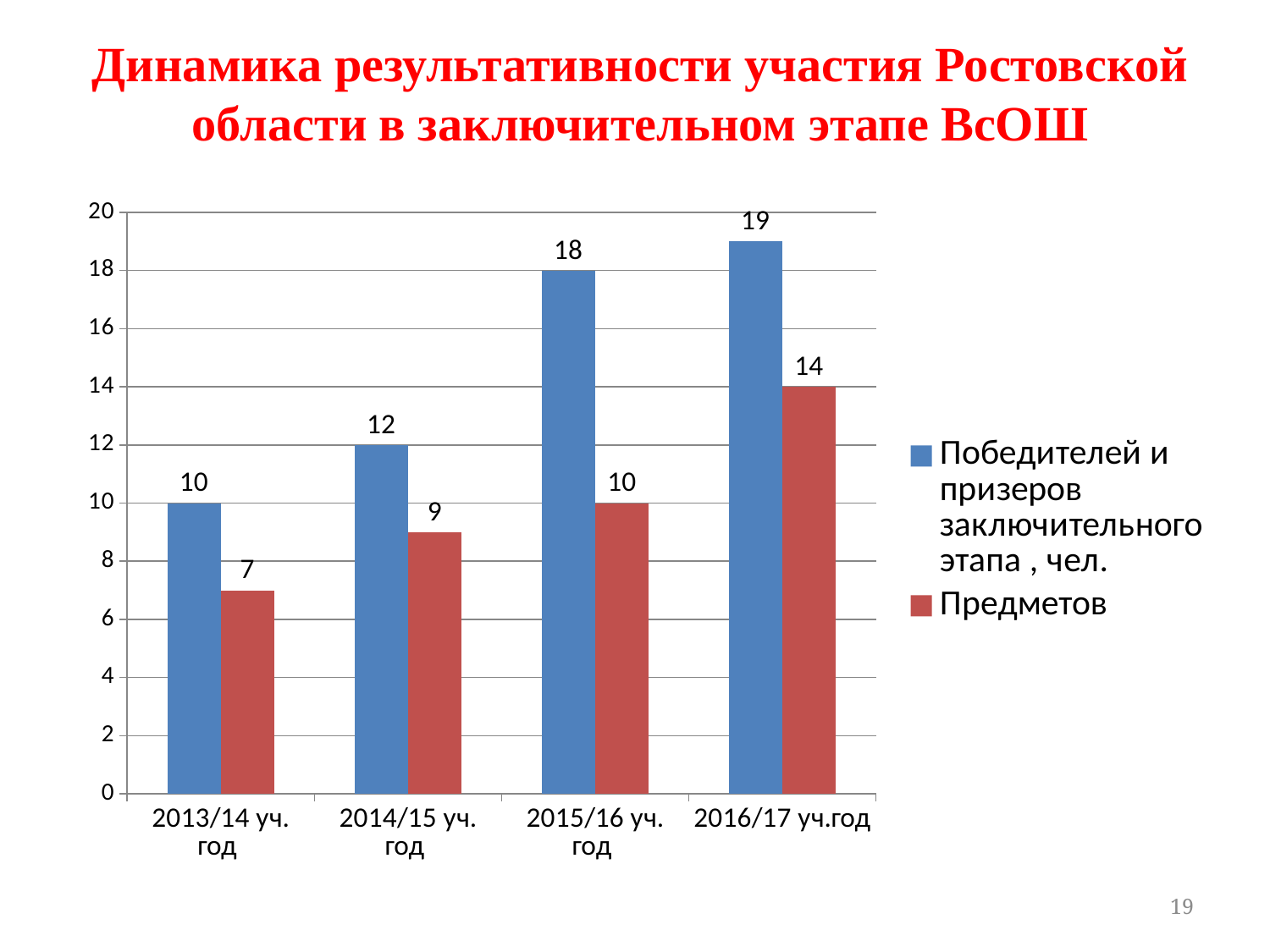
What colour are the bars for the 'Предметов' series? red In which year is the value for 'Предметов' lowest? 2013/14 уч. год Which is larger: 'Предметов' in 2014/15 уч. год or 'Предметов' in 2015/16 уч. год? 2015/16 уч. год What is the value for 'Предметов' in 2013/14 уч. год? 7 What kind of chart is shown on the slide? bar chart How many series does the legend list? 2 What is the difference between 'Победителей и призеров заключительного этапа, чел.' and 'Предметов' in 2015/16 уч. год? 8 What is the value for 'Предметов' in 2016/17 уч.год? 14 What is the value for 'Победителей и призеров заключительного этапа, чел.' in 2015/16 уч. год? 18 How many years (categories) are shown on the x axis? 4 Do the values for 'Победителей и призеров заключительного этапа, чел.' rise or fall from 2013/14 to 2016/17? rise In which year is the value for 'Победителей и призеров заключительного этапа, чел.' highest? 2016/17 уч.год